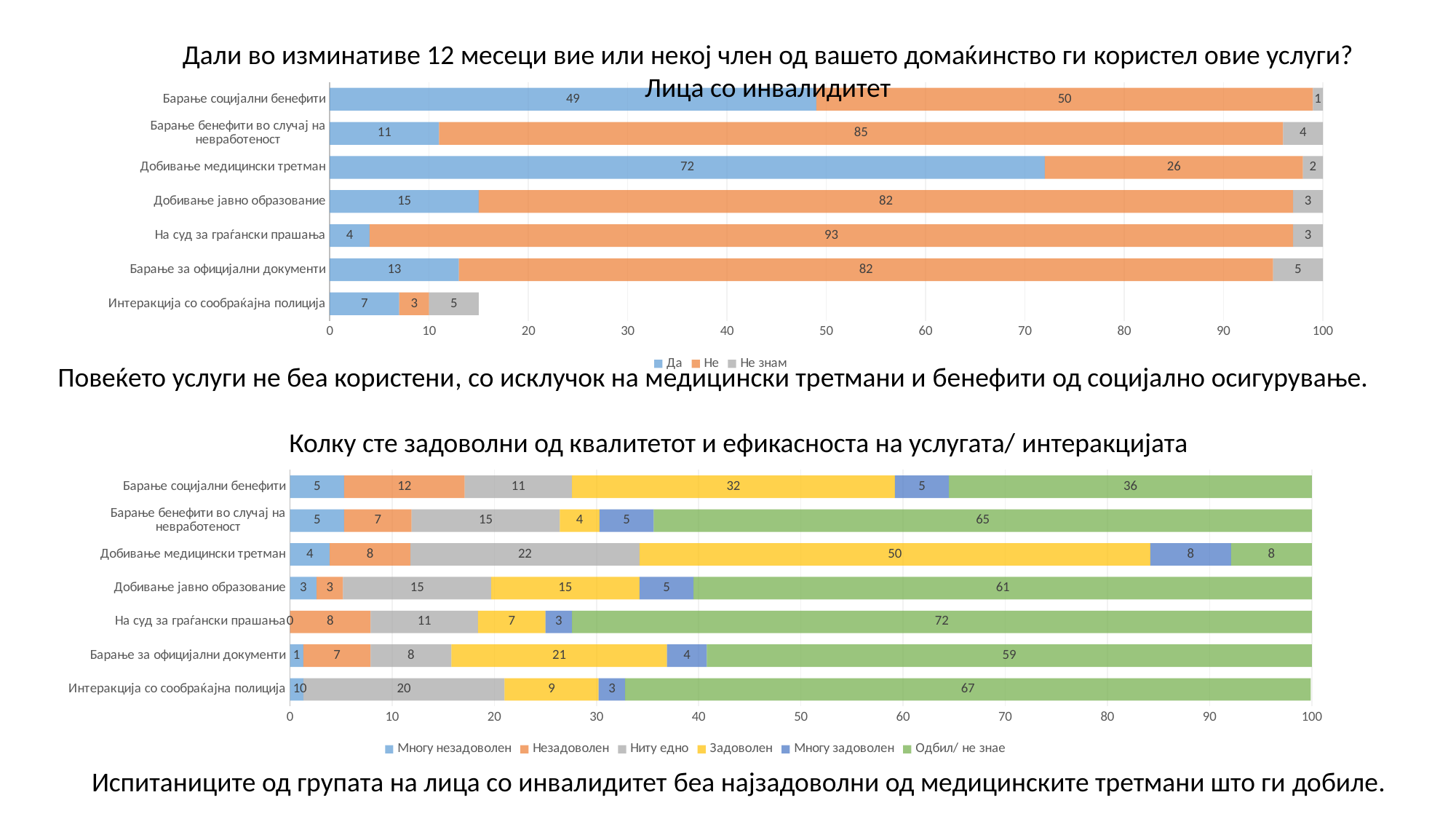
In the bottom chart (Колку сте задоволни...), how many series does the legend list? 6 In the top chart (Дали во изминативе 12 месеци...), what is the difference between the Не values for Барање бенефити во случај на невработеност and Добивање медицински третман? 59 In the bottom chart (Колку сте задоволни...), which is larger: the Одбил/ не знае value for Барање социјални бенефити or for Барање бенефити во случај на невработеност? Барање бенефити во случај на невработеност In the top chart (Дали во изминативе 12 месеци...), what is the total of the stacked bar for Интеракција со сообраќајна полиција? 15 In the top chart (Дали во изминативе 12 месеци...), what is the value of Не for На суд за граѓански прашања? 93 In the top chart (Дали во изминативе 12 месеци...), which category has the highest Да value? Добивање медицински третман In the top chart (Дали во изминативе 12 месеци...), what is the value of Да for Добивање медицински третман? 72 In the bottom chart (Колку сте задоволни...), what is the value of Задоволен for Добивање медицински третман? 50 In the bottom chart (Колку сте задоволни...), which category has the highest Задоволен value? Добивање медицински третман In the top chart (Дали во изминативе 12 месеци...), how many series does the legend list? 3 In the bottom chart (Колку сте задоволни...), what is the value of Одбил/ не знае for На суд за граѓански прашања? 72 What kind of chart is the bottom chart (Колку сте задоволни...)? Stacked bar chart